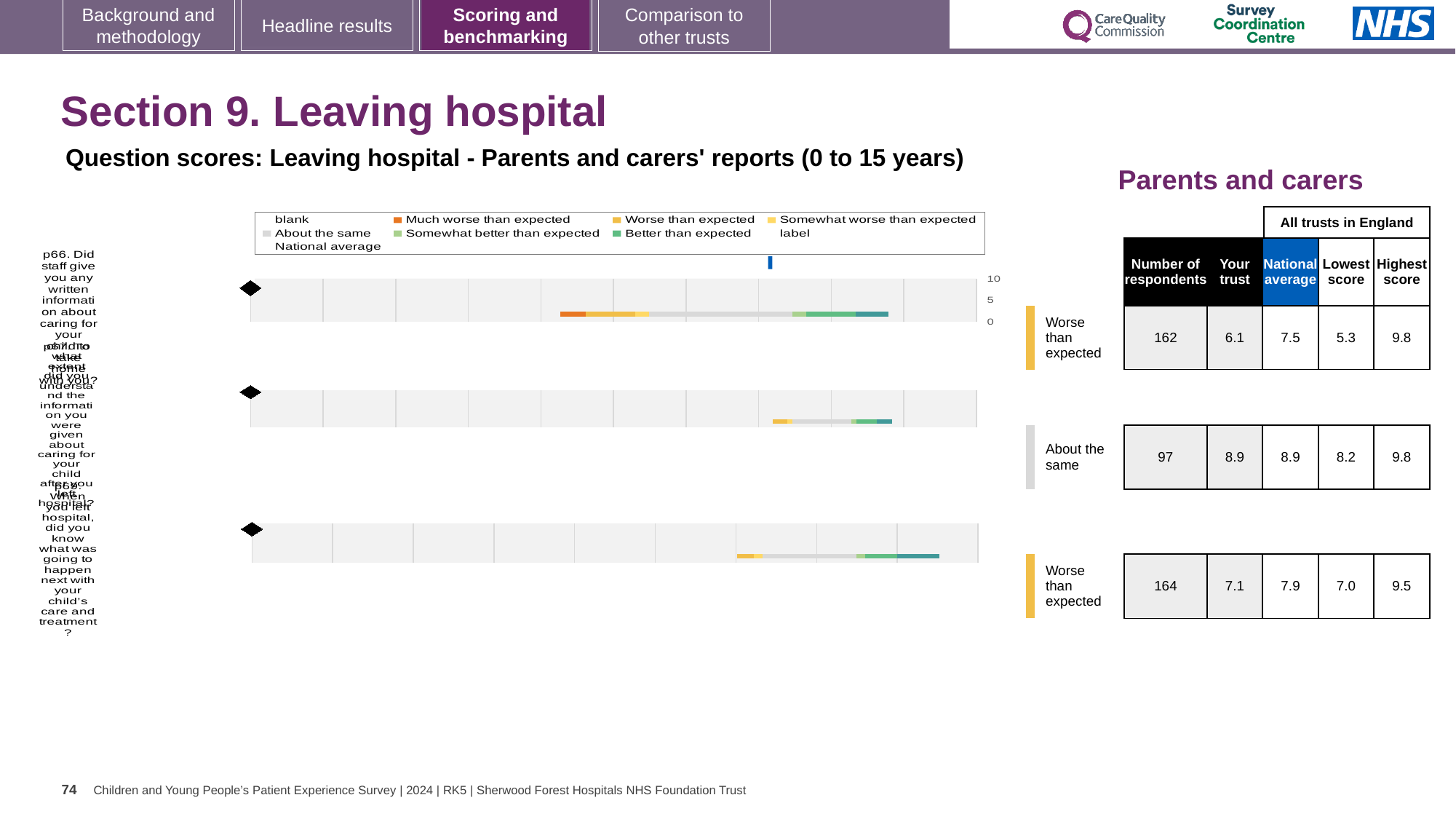
Is the 'Your trust' score for the third question row larger or smaller than its national average? smaller What is the difference between the national average and the 'Your trust' score for the first question row (p66)? 1.4 What benchmark category is shown for the second question row? About the same How many entries does the chart legend list? 9 What is the 'Your trust' score for the first question row (p66)? 6.1 What is the 'Your trust' score for the second question row? 8.9 What is the highest score across all trusts in England for the third question row? 9.5 What is the national average for the first question row (p66)? 7.5 Which question row has the lowest 'Your trust' score? the first row (p66) What kind of chart is used to show the question scores on this slide? bar chart What is the number of respondents for the first question row (p66)? 162 How many question rows are plotted in the benchmarking chart? 3